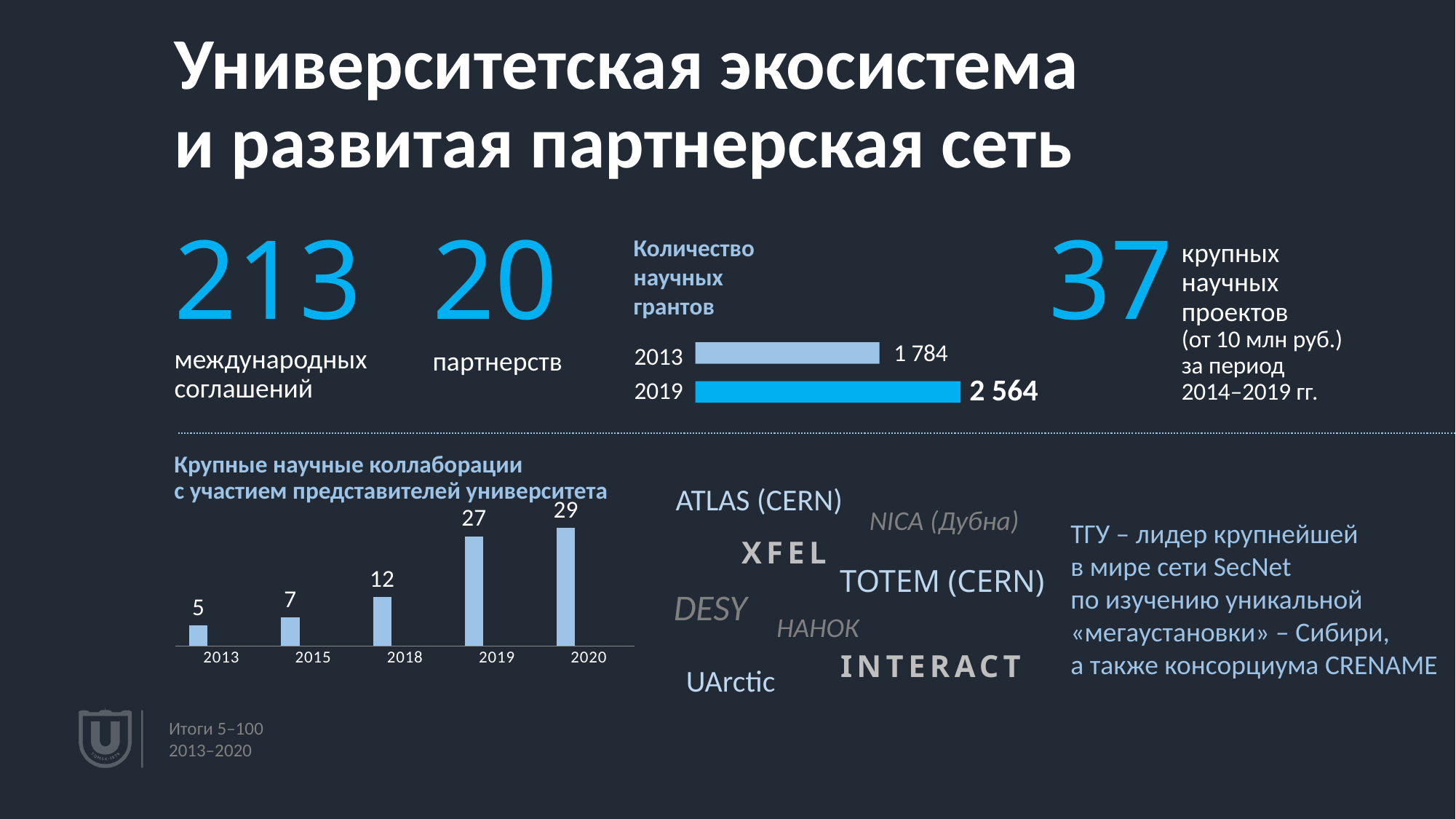
In the 'Крупные научные коллаборации' chart, what is the value for 2018? 12 In the 'Крупные научные коллаборации' chart, do the values rise or fall from 2013 to 2020? rise In the 'Крупные научные коллаборации' chart, which year has the highest value? 2020 In the 'Количество научных грантов' chart, which year has the larger value, 2013 or 2019? 2019 How many years are shown in the 'Крупные научные коллаборации' chart? 5 In the 'Количество научных грантов' chart, what is the value for 2019? 2 564 How many bars does the 'Количество научных грантов' chart show? 2 In the 'Количество научных грантов' chart, by how much does the 2019 value exceed the 2013 value? 780 In the 'Крупные научные коллаборации' chart, what is the difference between the 2019 and 2018 values? 15 In the 'Крупные научные коллаборации' chart, what is the value for 2015? 7 In the 'Количество научных грантов' chart, what is the value for 2013? 1 784 In the 'Крупные научные коллаборации' chart, which year has the lowest value? 2013